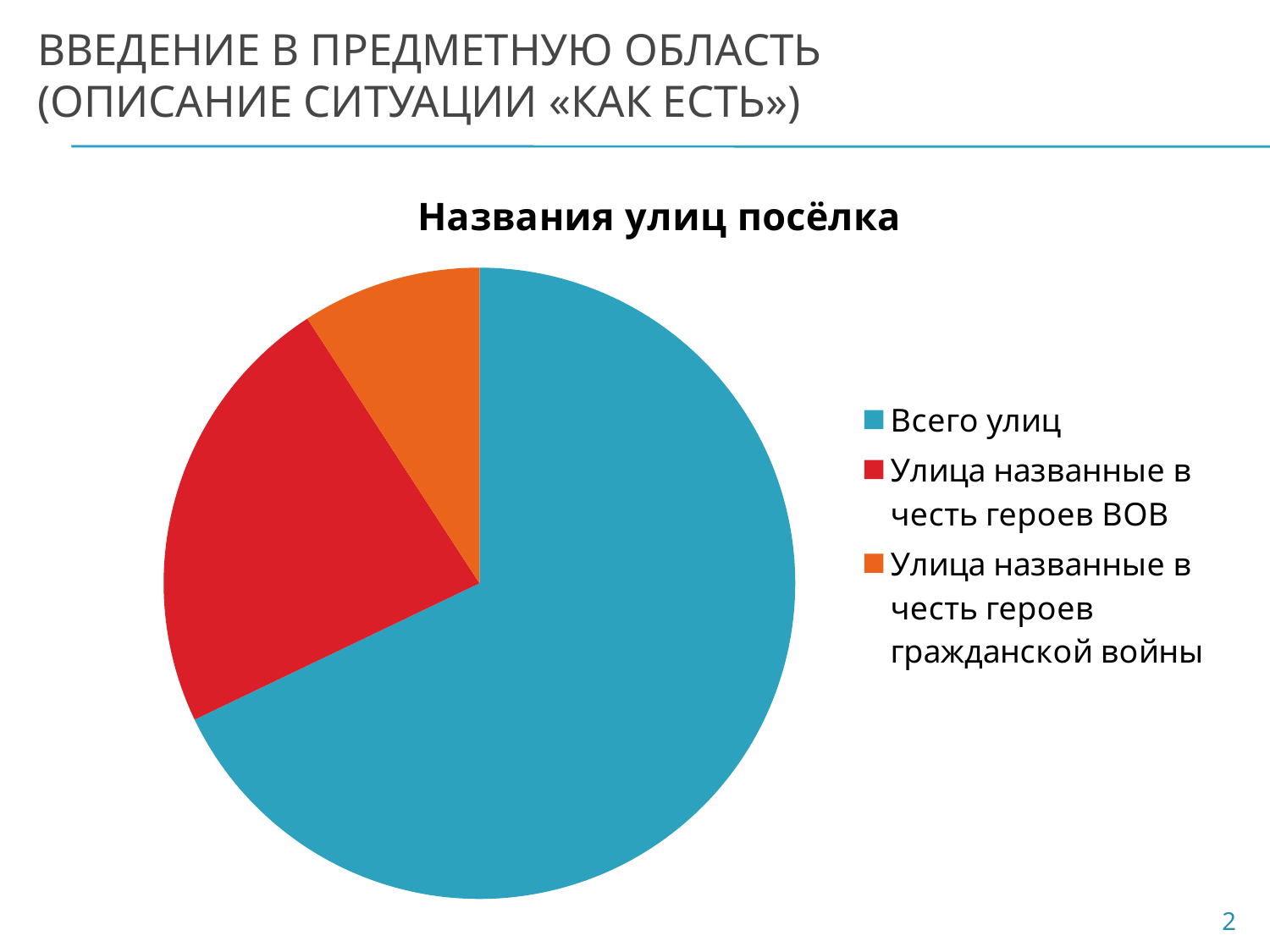
Which slice is larger: "Всего улиц" or "Улица названные в честь героев ВОВ"? Всего улиц What colour is the slice for "Улица названные в честь героев ВОВ"? red What kind of chart is shown on the slide? pie chart What is the title of the chart? Названия улиц посёлка Which category has the largest slice of the pie? Всего улиц Which slice is larger: "Улица названные в честь героев ВОВ" or "Улица названные в честь героев гражданской войны"? Улица названные в честь героев ВОВ Which category has the smallest slice of the pie? Улица названные в честь героев гражданской войны How many entries does the legend list? 3 How many slices does the pie chart have? 3 Does the slice for "Всего улиц" take up more or less than half of the pie? more